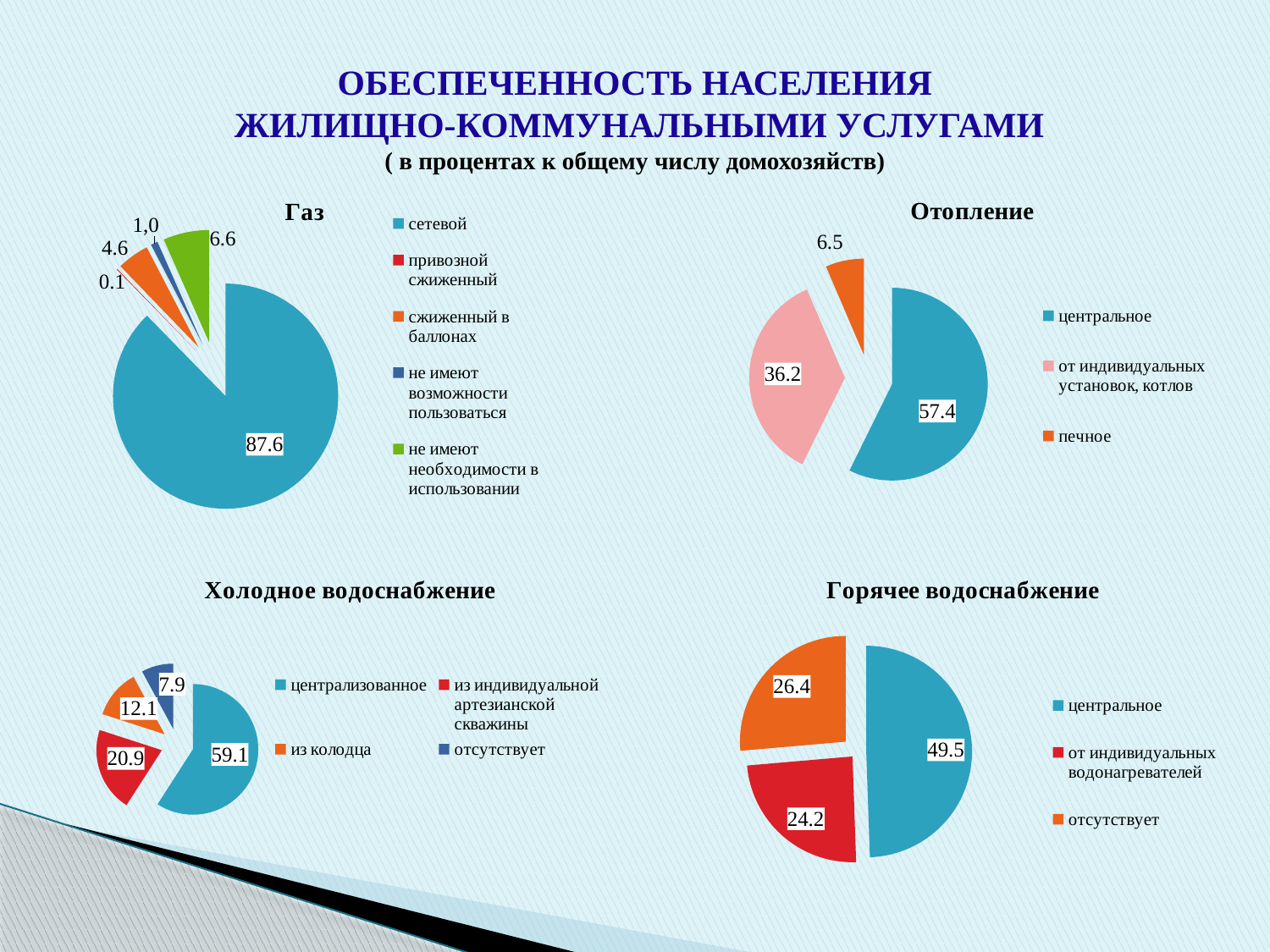
In the 'Газ' chart, what is the value for 'сжиженный в баллонах'? 4.6 How many pie charts are shown on the slide? 4 In the 'Холодное водоснабжение' chart, what is the value for 'из колодца'? 12.1 In the 'Горячее водоснабжение' chart, which category has the largest share? центральное What type of chart is used for 'Отопление'? pie chart In the 'Отопление' chart, what is the difference between 'центральное' and 'печное'? 50.9 In the 'Отопление' chart, what is the value for 'от индивидуальных установок, котлов'? 36.2 In the 'Горячее водоснабжение' chart, what is the value for 'отсутствует'? 26.4 In the 'Газ' chart, which category has the smallest share? привозной сжиженный In the 'Газ' chart, what is the value for 'сетевой'? 87.6 How many categories does the legend of the 'Газ' chart list? 5 In the 'Холодное водоснабжение' chart, which is larger: 'из индивидуальной артезианской скважины' or 'отсутствует'? из индивидуальной артезианской скважины